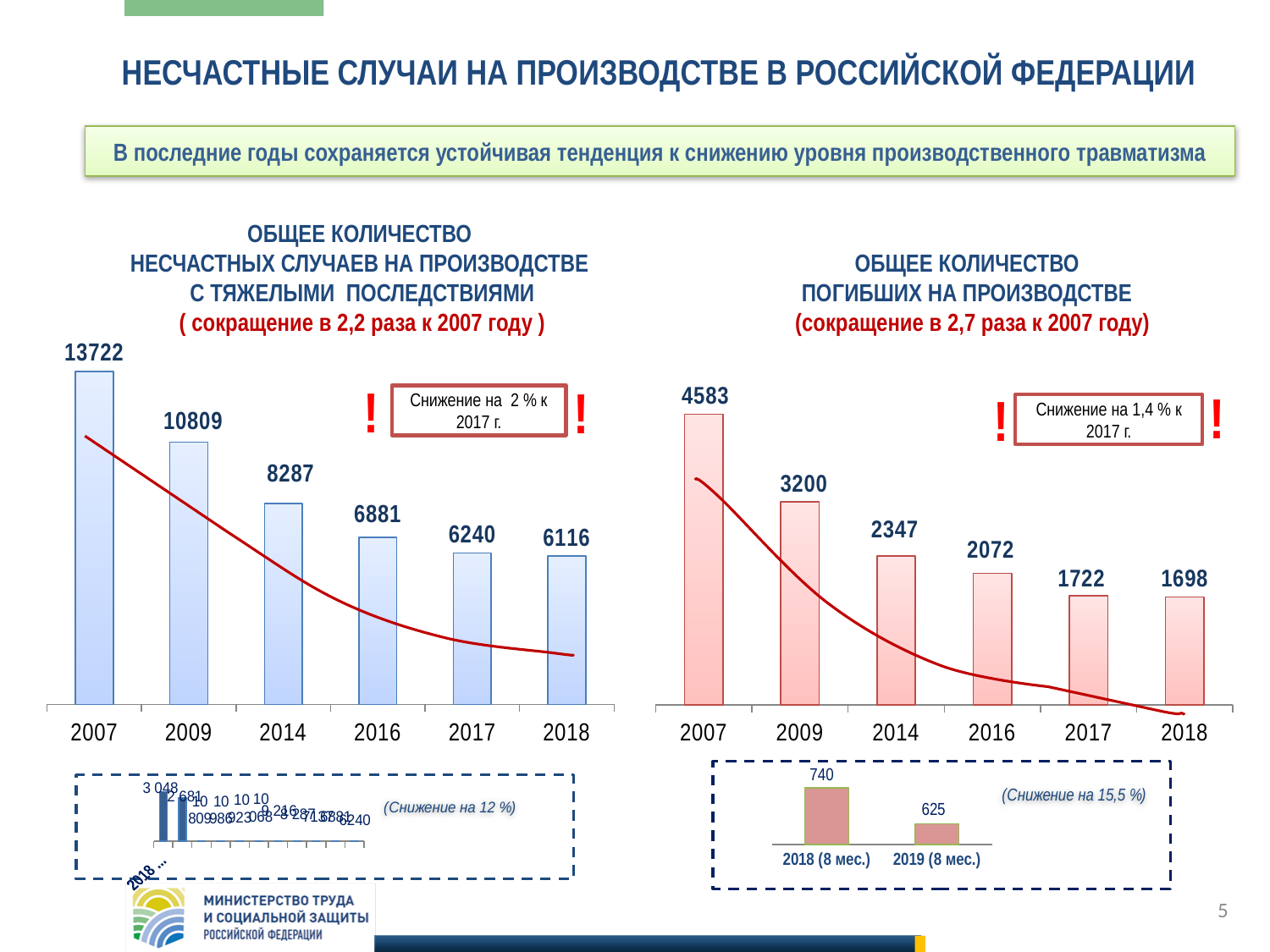
What type of chart is the right chart (total number of workplace fatalities)? Bar chart In the left chart (total number of workplace accidents with severe consequences), what is the value for 2018? 6116 In the right chart (total number of workplace fatalities), do the values rise or fall from 2007 to 2018? Fall How many years are shown on the x axis of the left chart (total number of workplace accidents with severe consequences)? 6 In the right chart (total number of workplace fatalities), what is the difference between the 2007 and 2009 values? 1383 In the right chart (total number of workplace fatalities), which is larger: the value for 2016 or the value for 2017? 2016 In the small chart at the bottom right, what is the value for 2019 (8 мес.)? 625 In the right chart (total number of workplace fatalities), which year has the lowest value? 2018 In the left chart (total number of workplace accidents with severe consequences), which year has the highest value? 2007 In the left chart (total number of workplace accidents with severe consequences), what is the value for 2007? 13722 In the left chart (total number of workplace accidents with severe consequences), what is the difference between the 2017 and 2018 values? 124 In the right chart (total number of workplace fatalities), what is the value for 2014? 2347